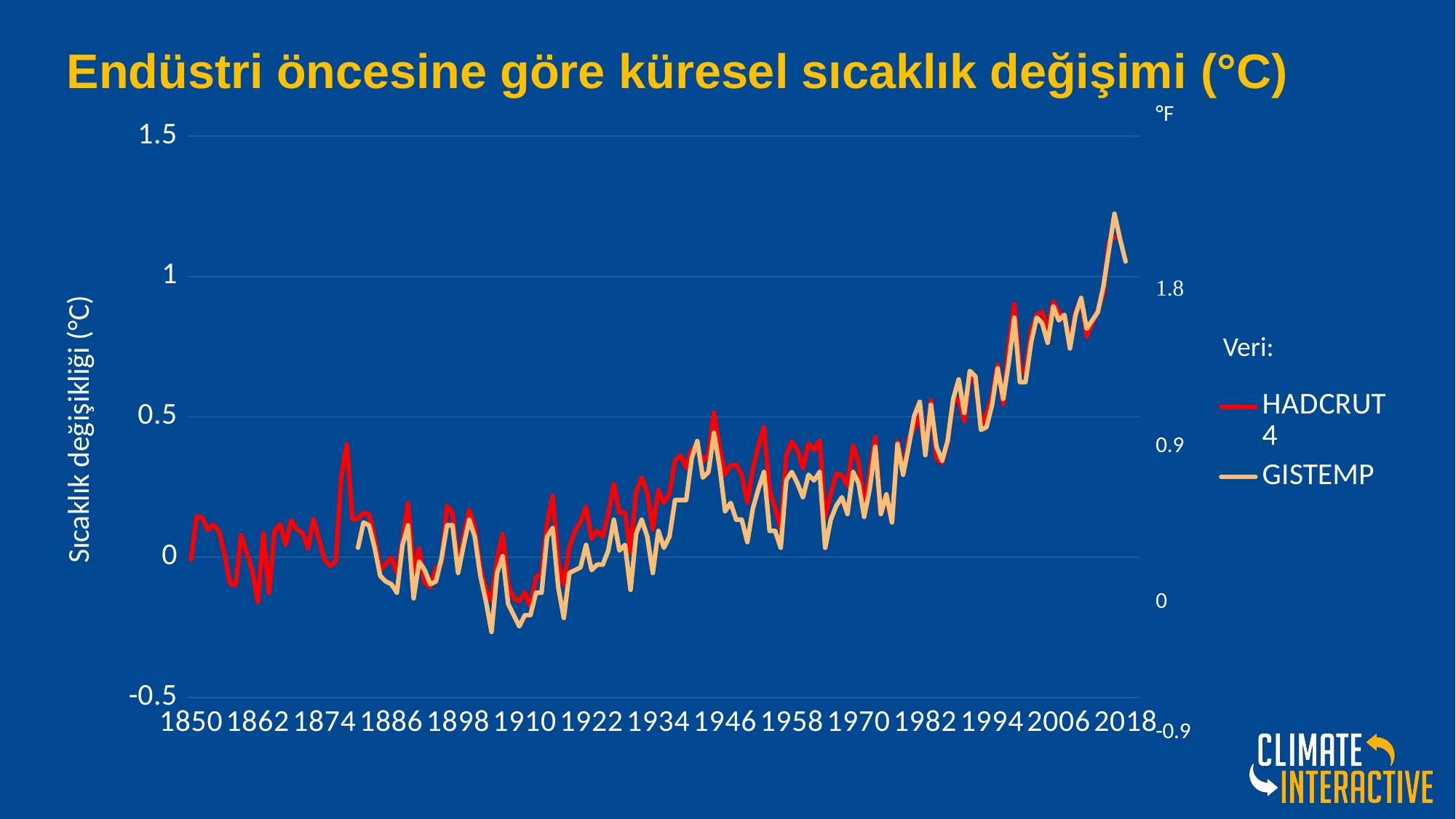
What are the two series named in the legend? HADCRUT4 and GISTEMP How many year labels are shown on the x axis? 15 Is the value for GISTEMP in 1910 greater or less than 0? less What is the title of the chart? Endüstri öncesine göre küresel sıcaklık değişimi (°C) Is the value for HADCRUT4 in 1850 greater or less than 0.5? less Is the value for HADCRUT4 in 1970 greater or less than 0.5? less Overall, do the plotted values rise or fall from 1850 to 2018? rise How many series does the legend list? 2 What kind of chart is shown on the slide? line chart